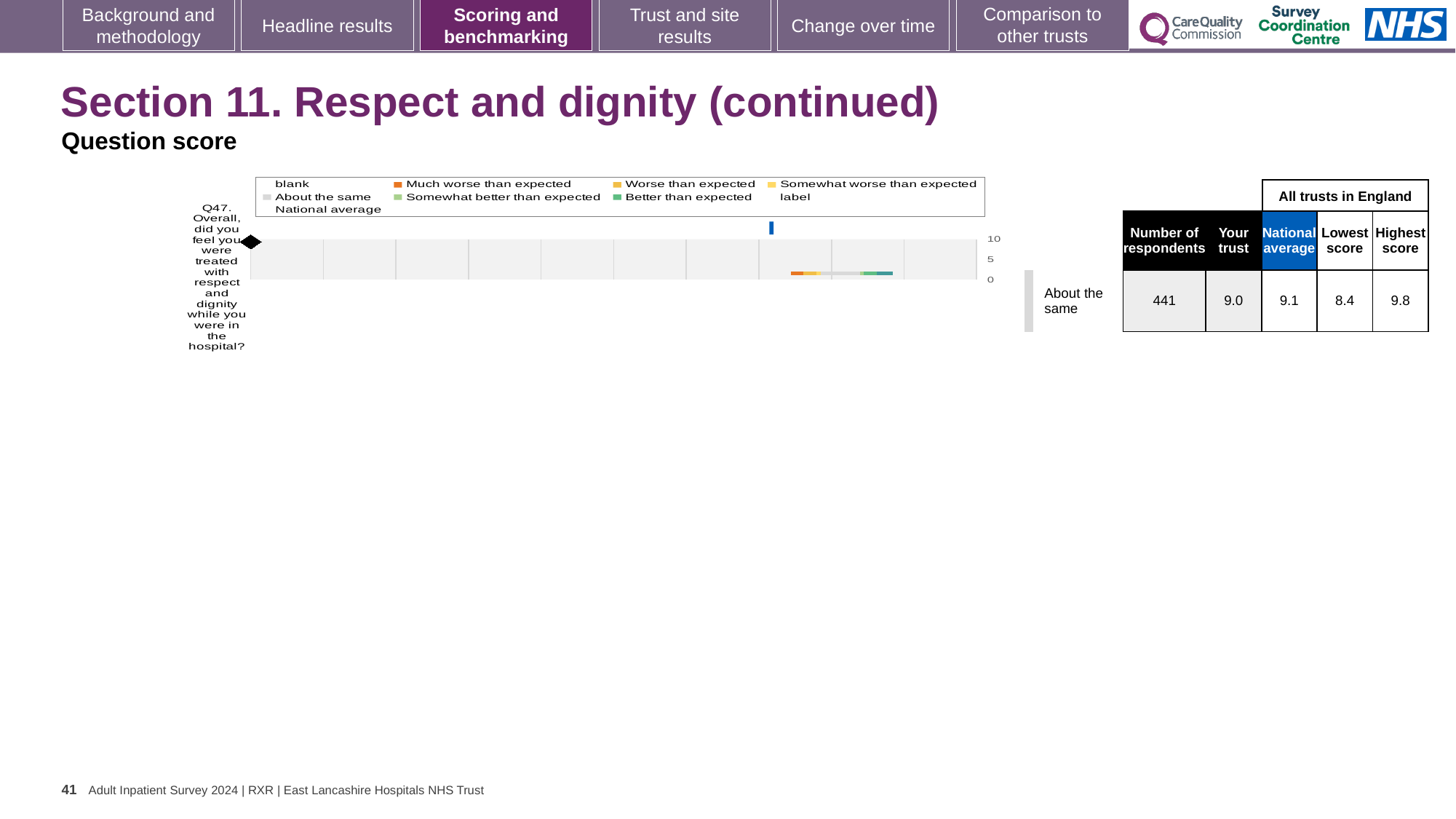
How many questions (categories) are plotted on the chart? 1 In the table next to the chart, what is the national average score for Q47? 9.1 In the table next to the chart, how many respondents answered Q47? 441 What kind of chart is shown on the slide? bar chart In the table next to the chart, what is the highest score among all trusts in England for Q47? 9.8 What is the difference between the highest score and the lowest score for Q47 in the table? 1.4 Which question number is plotted on the chart? Q47 What benchmark category is the trust's Q47 score assigned to on the slide? About the same What is the highest tick value shown on the chart's score axis? 10 Which is larger for Q47, the 'Your trust' score or the national average? national average In the table next to the chart, what is the 'Your trust' score for Q47? 9.0 In the table next to the chart, what is the lowest score among all trusts in England for Q47? 8.4